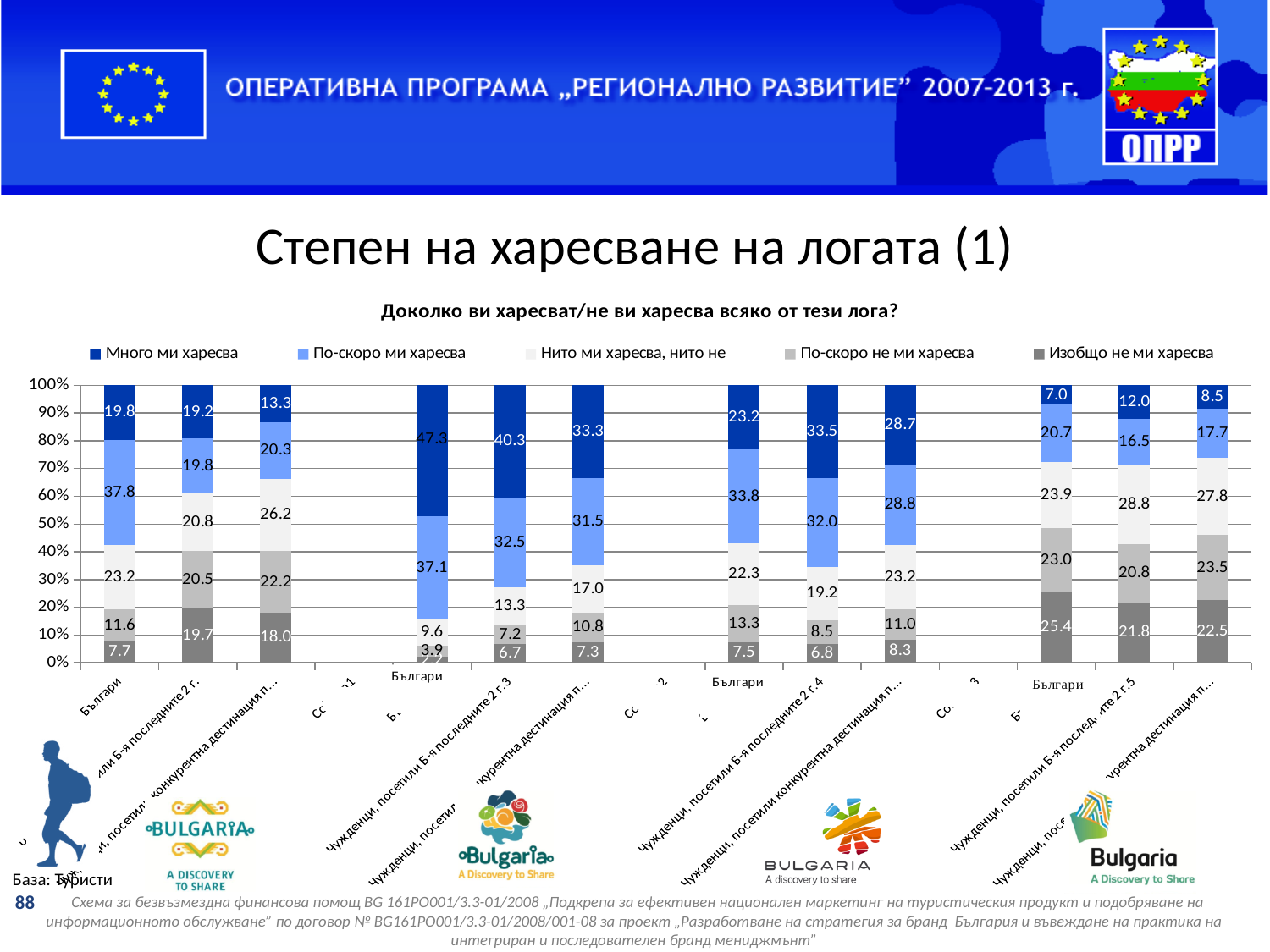
In the leftmost bar, what is the value for "Много ми харесва"? 19.8 Which has a larger "Много ми харесва" value: the leftmost bar or the rightmost bar? The leftmost bar How many series does the chart legend list? 5 Which bar has the highest value for "Много ми харесва"? The fourth bar from the left (47.3) In the fifth bar from the left, what is the value for "Много ми харесва"? 40.3 In the rightmost bar, what is the value for "Изобщо не ми харесва"? 22.5 In the leftmost bar, what is the value for "По-скоро ми харесва"? 37.8 Which bar has the lowest value for "Изобщо не ми харесва"? The fourth bar from the left What kind of chart is shown on the slide? Stacked bar chart How many bars are plotted in the chart? 12 In the leftmost bar, what is the difference between the "По-скоро ми харесва" value and the "Много ми харесва" value? 18.0 What is the chart's title? Доколко ви харесват/не ви харесва всяко от тези лога?